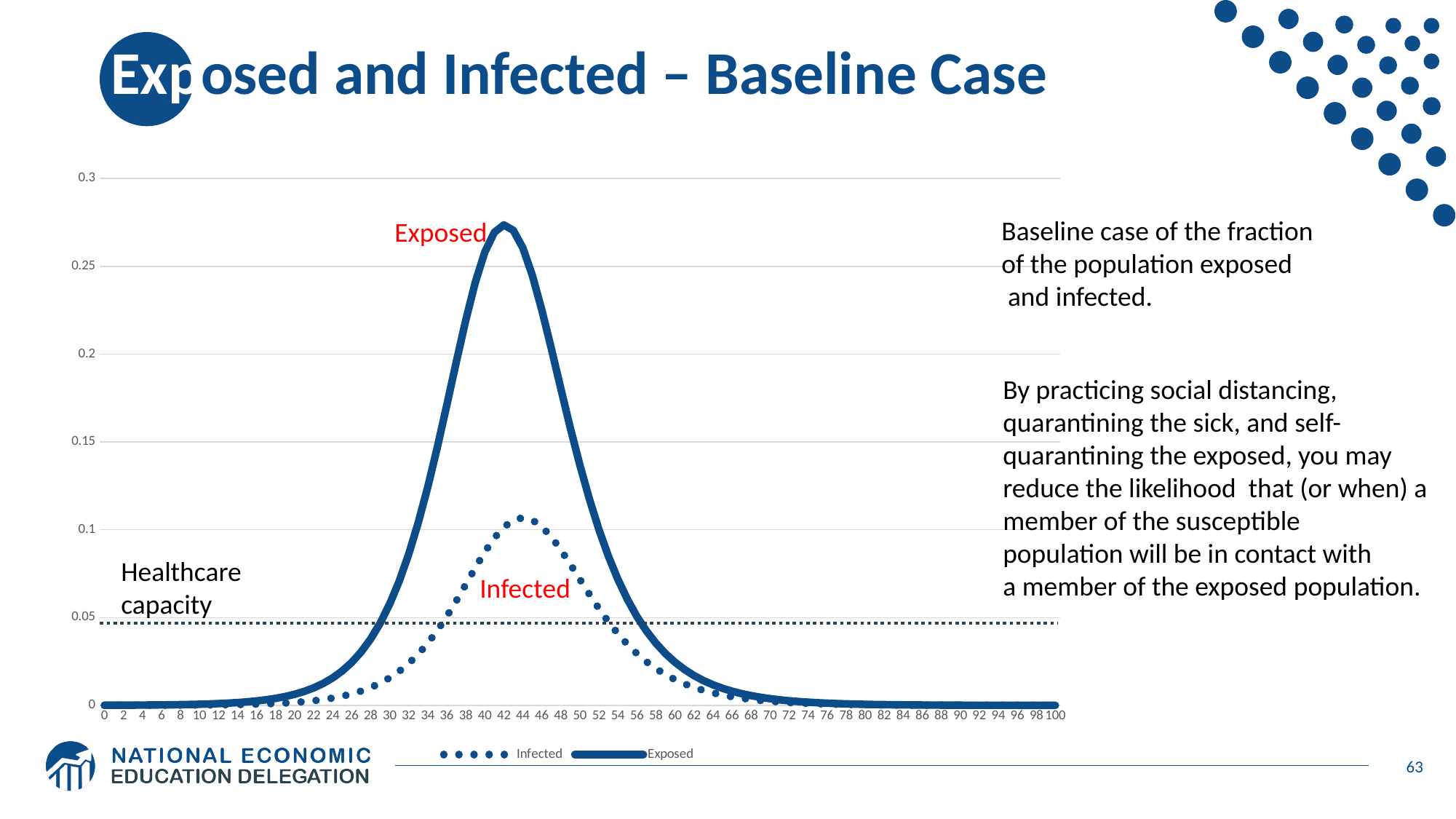
Is the peak value of the Infected series greater or less than 0.1? greater What is the highest value shown on the y axis? 0.3 What kind of chart is shown on the slide? line chart Does the Infected series rise or fall between x = 20 and x = 40? rise Is the value of the Exposed series at x = 0 greater or less than 0.05? less How many series does the legend list? 2 Does the Exposed series rise or fall between x = 60 and x = 100? fall What are the two series named in the legend? Infected and Exposed Which series is drawn as a dotted line, Infected or Exposed? Infected Is the peak value of the Exposed series greater or less than 0.25? greater Which series reaches the higher peak, Exposed or Infected? Exposed